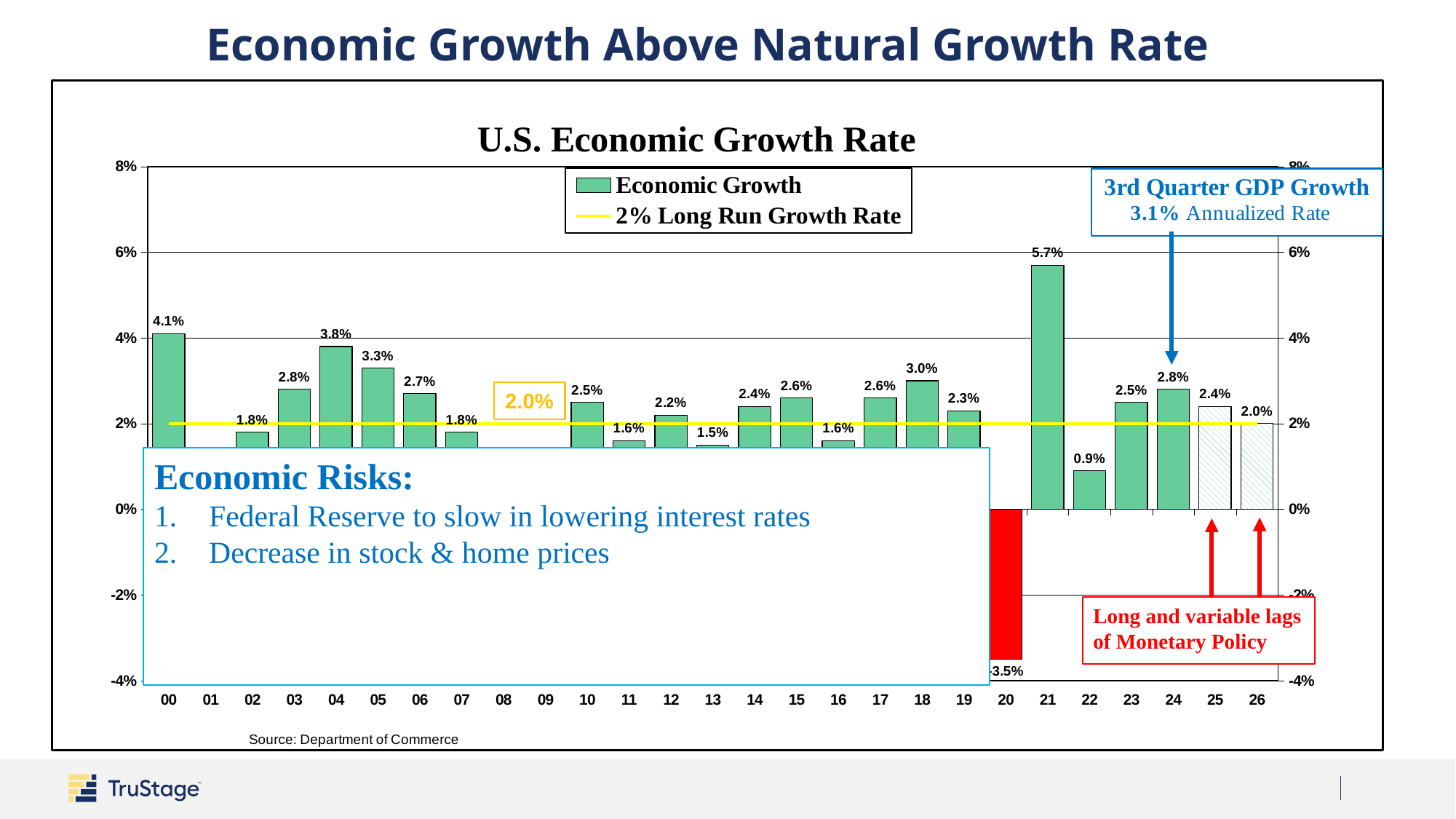
In the U.S. Economic Growth Rate chart, what is the economic growth value for 22? 0.9% What is the title of the chart on the slide? U.S. Economic Growth Rate Which year has the lowest economic growth in the U.S. Economic Growth Rate chart? 20 In the U.S. Economic Growth Rate chart, what is the economic growth value for 21? 5.7% What kind of chart is used to show the U.S. Economic Growth Rate? Bar chart How many series does the legend of the U.S. Economic Growth Rate chart list? 2 In the U.S. Economic Growth Rate chart, what is the economic growth value for 20? -3.5% Which year has the highest economic growth in the U.S. Economic Growth Rate chart? 21 In the U.S. Economic Growth Rate chart, what is the difference between the economic growth values for 04 and 03? 1.0% In the U.S. Economic Growth Rate chart, which year has the larger economic growth value, 18 or 19? 18 In the U.S. Economic Growth Rate chart, what is the economic growth value for 25? 2.4% In the U.S. Economic Growth Rate chart, what is the difference between the economic growth values for 21 and 22? 4.8%